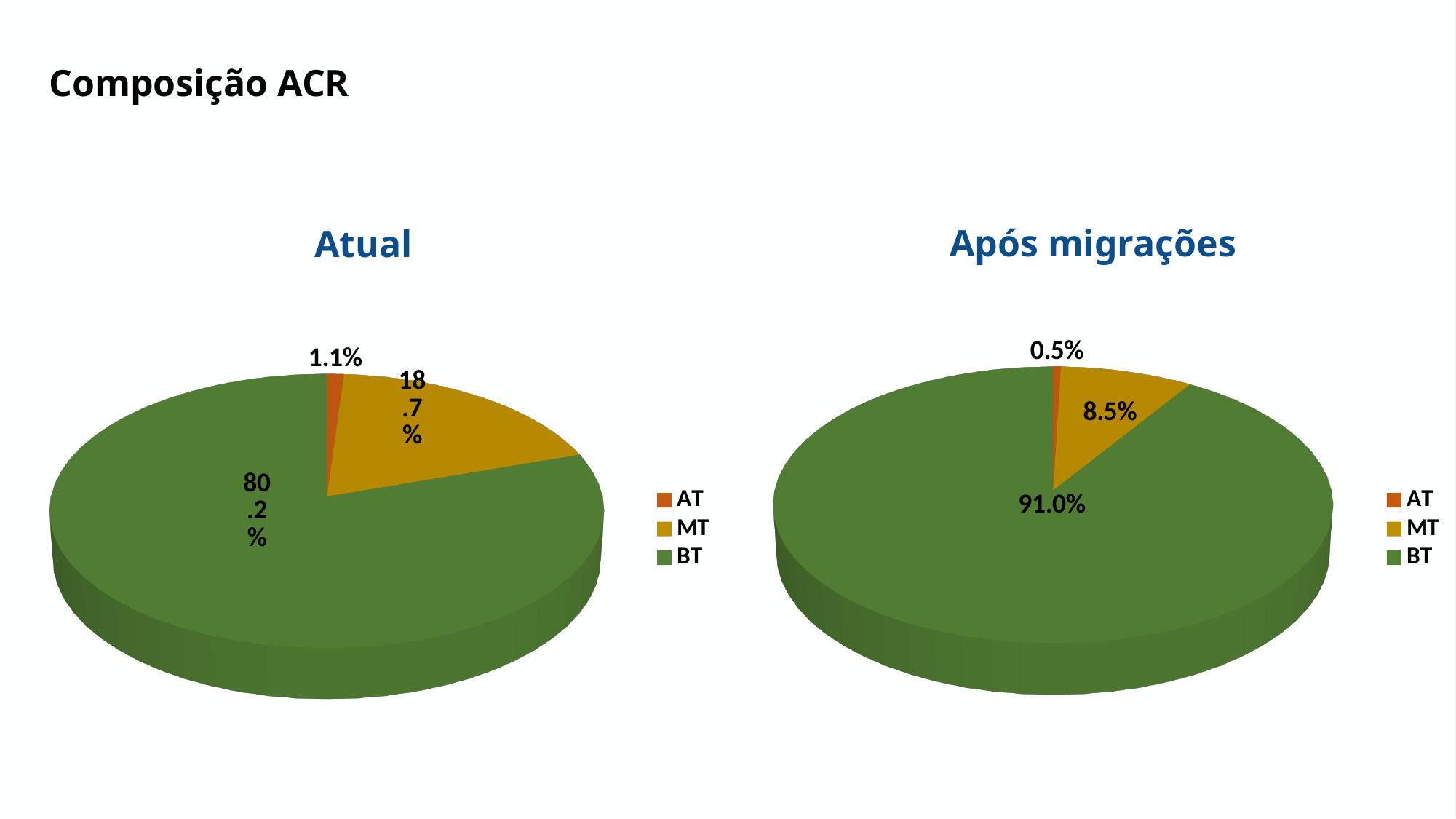
How many categories does the legend of the 'Atual' chart list? 3 In the 'Após migrações' pie chart, what is the share for AT? 0.5% What type of chart is used for 'Atual' and 'Após migrações'? Pie chart Is the MT share larger in the 'Atual' chart or in the 'Após migrações' chart? Atual In the 'Atual' pie chart, what is the share for MT? 18.7% In the 'Após migrações' pie chart, what is the share for MT? 8.5% In the 'Após migrações' pie chart, what is the share for BT? 91.0% In the 'Atual' pie chart, what is the share for BT? 80.2% In the 'Atual' pie chart, which category has the largest share? BT In the 'Após migrações' pie chart, which category has the smallest share? AT In the 'Atual' pie chart, what is the share for AT? 1.1% What is the difference between the BT share in the 'Após migrações' chart and the BT share in the 'Atual' chart? 10.8%